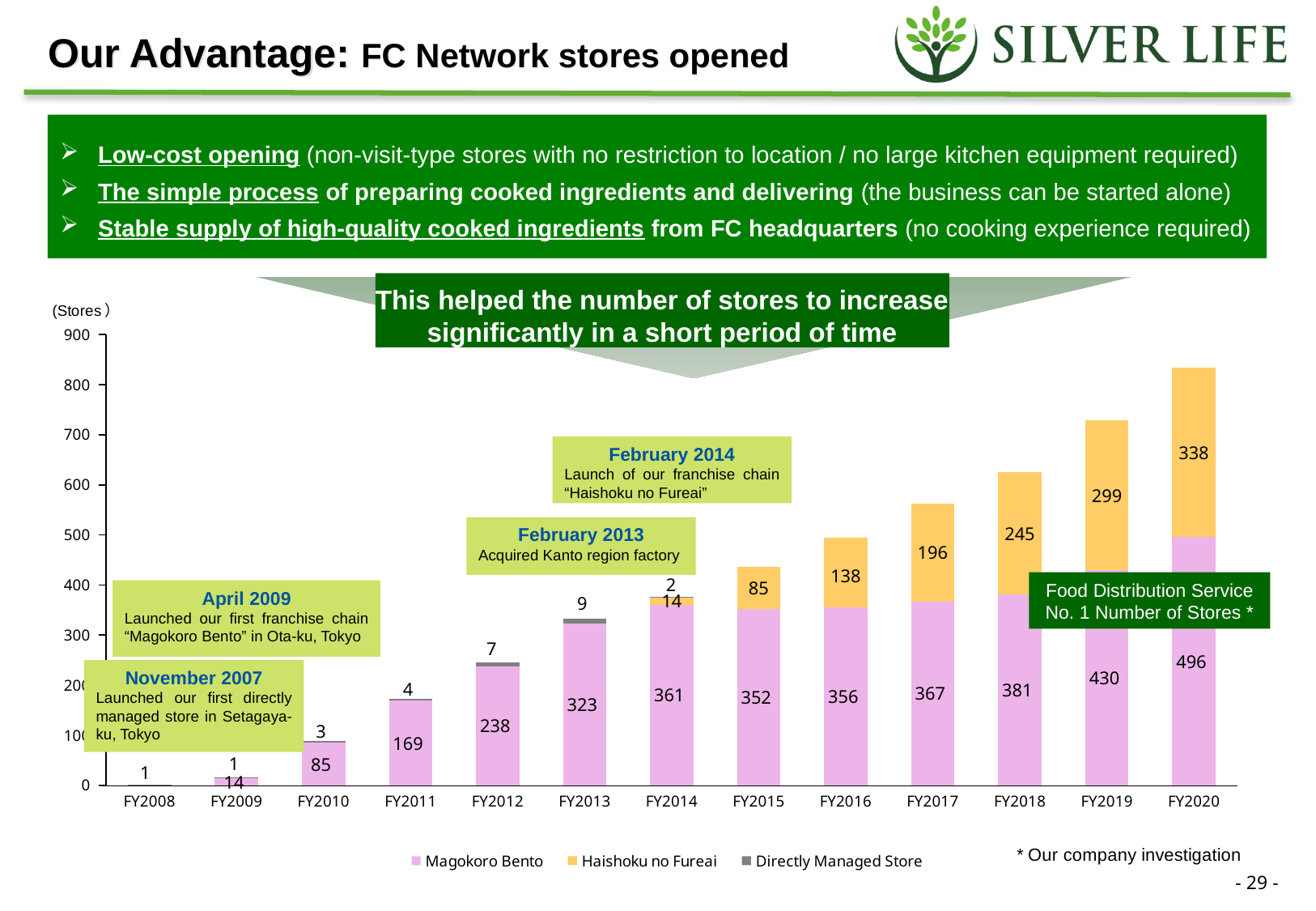
Is the total height of the FY2018 bar greater or less than 600? greater In which fiscal year is the Magokoro Bento value highest? FY2020 How many fiscal years are shown on the x axis? 13 Do the Haishoku no Fureai values rise or fall from FY2014 to FY2020? Rise How many series does the legend list? 3 What is the value for Haishoku no Fureai in FY2017? 196 What is the total of the stacked bar for FY2012? 245 What is the value for Directly Managed Store in FY2013? 9 What kind of chart is shown on the slide? Stacked bar chart What is the difference between the Haishoku no Fureai values for FY2020 and FY2019? 39 Which is larger, the Magokoro Bento value for FY2015 or for FY2016? FY2016 What is the value for Magokoro Bento in FY2020? 496